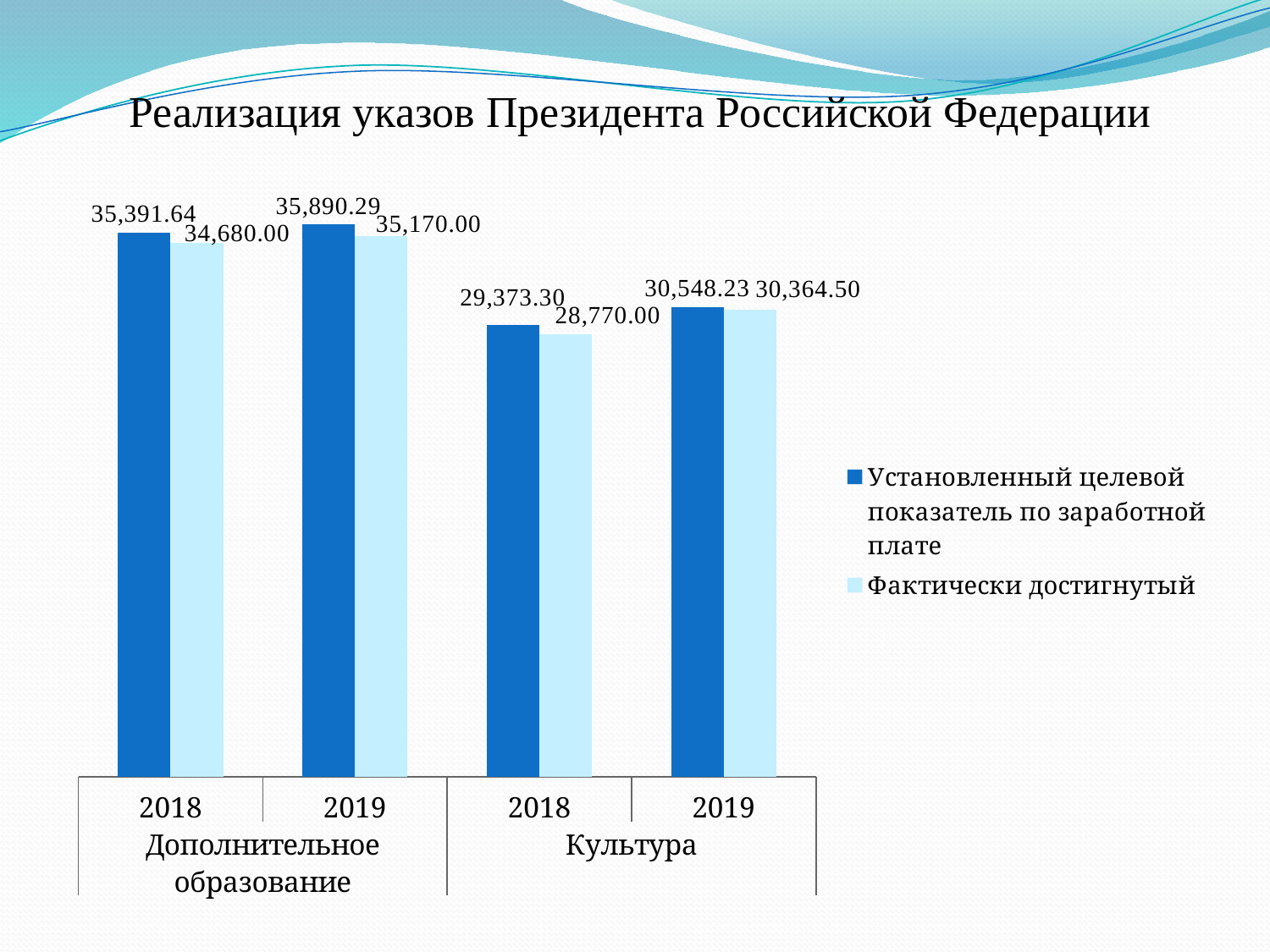
What is the difference between the target (35,391.64) and the actual (34,680.00) for Дополнительное образование in 2018? 711.64 How many category groups (year bars) are shown along the x axis? 4 What is the value of 'Фактически достигнутый' for Культура in 2019? 30,364.50 What is the difference between the target (30,548.23) and the actual (30,364.50) for Культура in 2019? 183.73 Which category has the lowest value for 'Фактически достигнутый'? Культура 2018 What is the value of 'Фактически достигнутый' for Дополнительное образование in 2019? 35,170.00 For Культура in 2018, which is larger: the target value or the actually achieved value? The target value (29,373.30) What is the value of 'Установленный целевой показатель по заработной плате' for Культура in 2018? 29,373.30 How many series does the legend list? 2 What type of chart is shown on the slide? Bar chart What is the value of 'Установленный целевой показатель по заработной плате' for Дополнительное образование in 2018? 35,391.64 Which category has the highest value for 'Установленный целевой показатель по заработной плате'? Дополнительное образование 2019